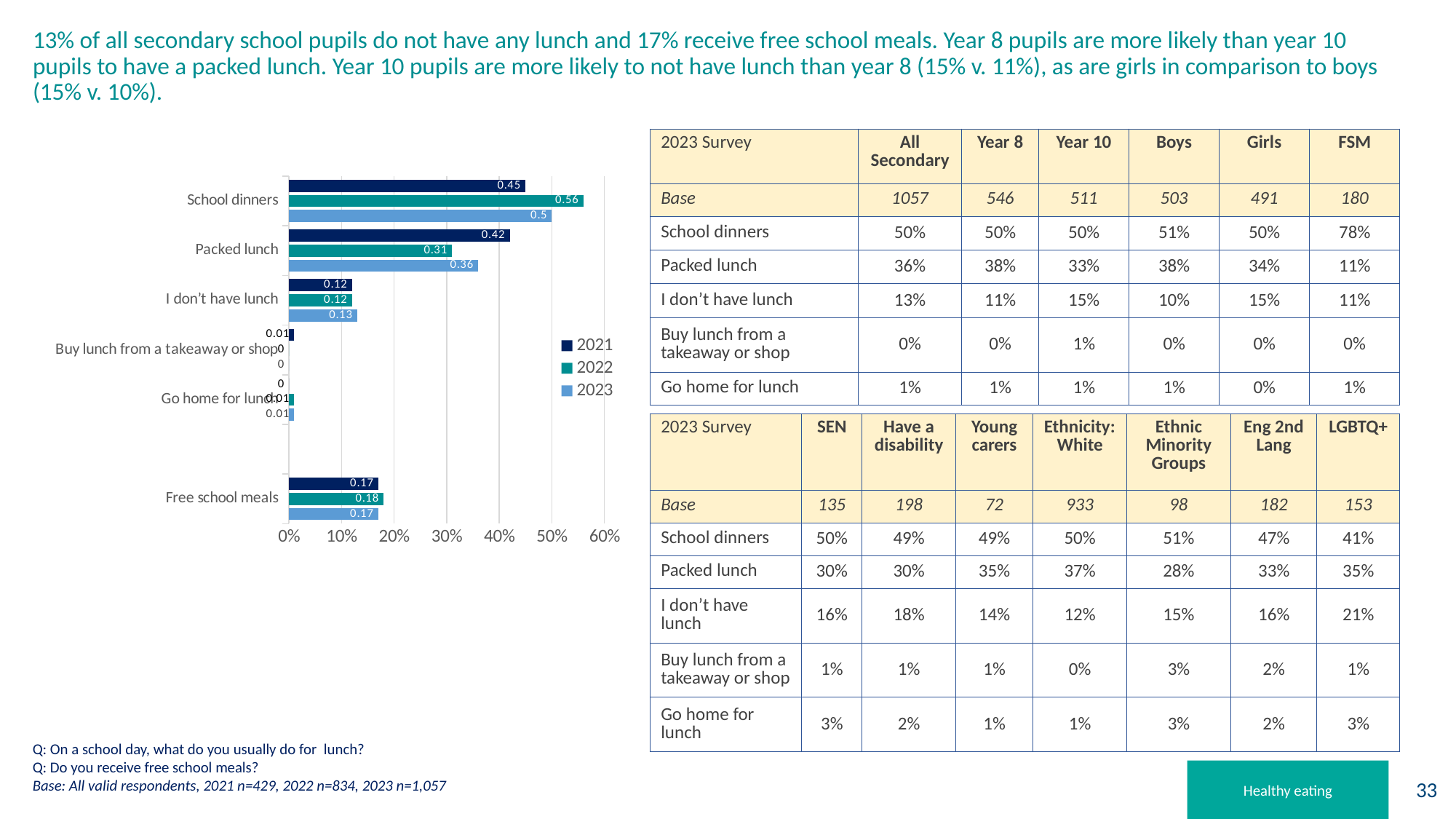
Which category has the highest 2022 value in the bar chart? School dinners What is the 2022 value for Free school meals in the bar chart? 0.18 What is the 2023 value for 'I don't have lunch' in the bar chart? 0.13 What is the 2021 value for Packed lunch in the bar chart? 0.42 How many categories are shown on the bar chart? 6 What kind of chart is shown on the slide? Bar chart What is the 2022 value for School dinners in the bar chart? 0.56 How many series does the bar chart's legend list? 3 For School dinners, which year has the highest value in the bar chart? 2022 What is the difference between the 2023 and 2022 values for Packed lunch in the bar chart? 0.05 What is the difference between the 2022 and 2021 values for School dinners in the bar chart? 0.11 For Packed lunch, which is larger in the bar chart: the 2021 value or the 2023 value? 2021